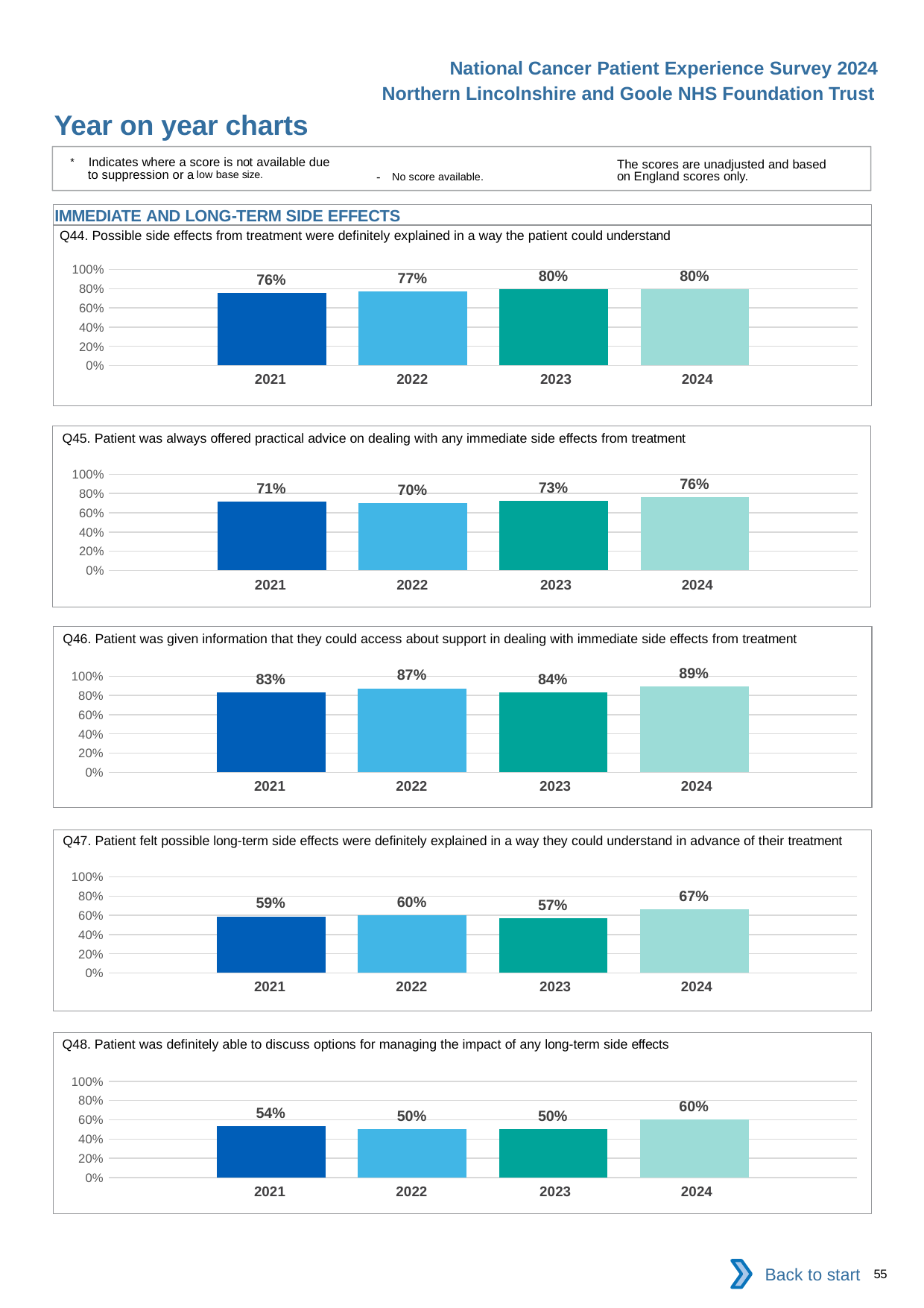
What is the section heading above the Q44 chart? IMMEDIATE AND LONG-TERM SIDE EFFECTS In the Q48 chart, what is the value for 2022? 50% In the Q45 chart, which year has the highest value? 2024 In the Q46 chart, what is the difference between the 2024 and 2021 values? 6% What kind of chart is the Q46 chart? bar chart In the Q48 chart, is the value for 2024 greater or less than 40%? greater How many years are shown in the Q47 chart? 4 In the Q44 chart, what is the value for 2021? 76% In the Q45 chart, which year has the lowest value? 2022 In the Q47 chart, what is the difference between the 2024 and 2023 values? 10% In the Q44 chart, do the values rise or fall from 2021 to 2023? rise In the Q47 chart, which is larger, the value for 2022 or the value for 2023? 2022